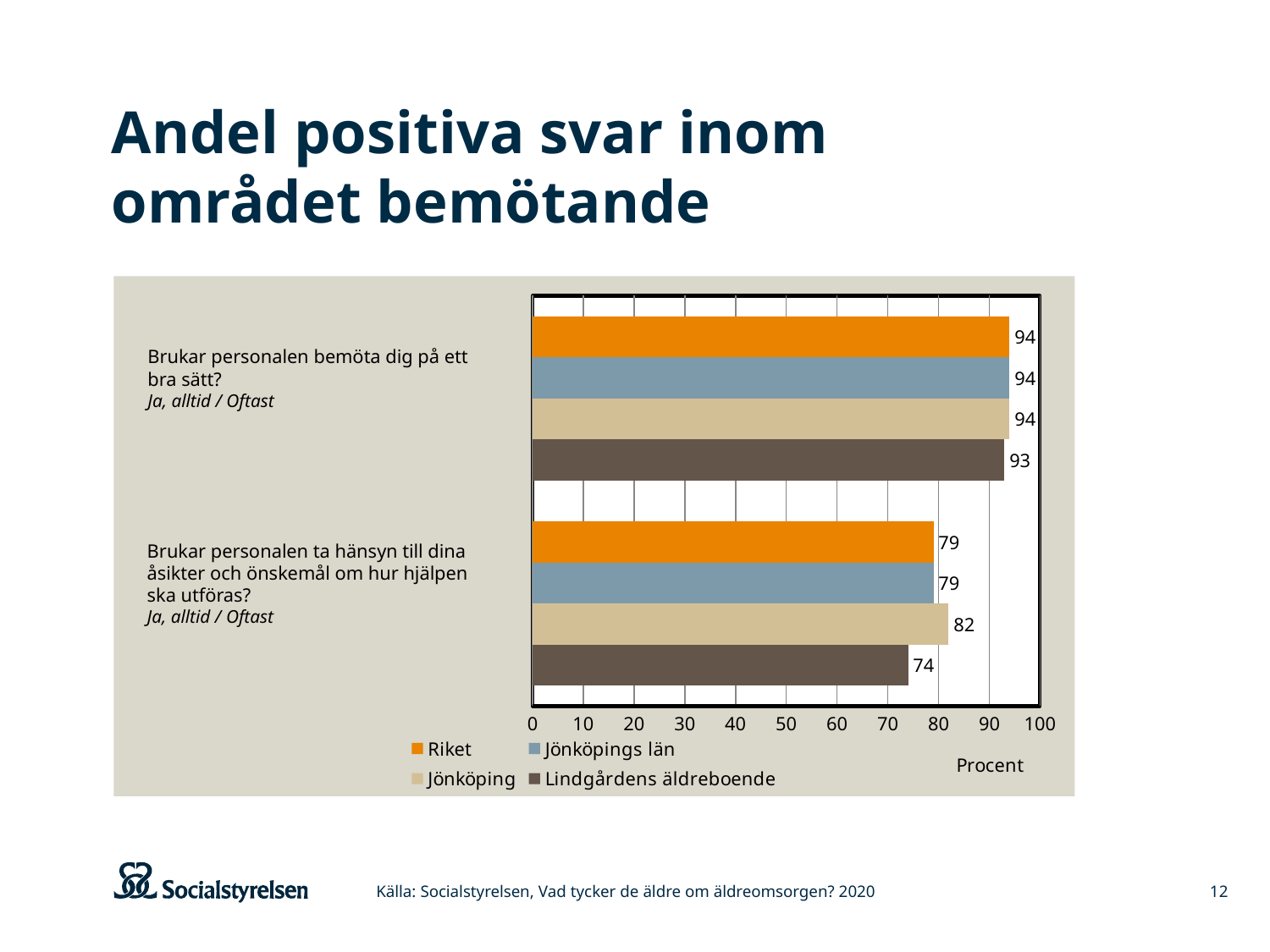
For Lindgårdens äldreboende, which question has the larger value: "Brukar personalen bemöta dig på ett bra sätt?" or "Brukar personalen ta hänsyn till dina åsikter och önskemål om hur hjälpen ska utföras?" Brukar personalen bemöta dig på ett bra sätt? What is the value for Jönköping for the question "Brukar personalen ta hänsyn till dina åsikter och önskemål om hur hjälpen ska utföras?" 82 What is the difference between the Jönköping and Lindgårdens äldreboende values for the question "Brukar personalen ta hänsyn till dina åsikter och önskemål om hur hjälpen ska utföras?" 8 Which series has the lowest value for the question "Brukar personalen ta hänsyn till dina åsikter och önskemål om hur hjälpen ska utföras?" Lindgårdens äldreboende What is the value for Riket for the question "Brukar personalen bemöta dig på ett bra sätt?" 94 Which series is shown in orange in the legend? Riket What is the label of the x axis? Procent Which series has the highest value for the question "Brukar personalen ta hänsyn till dina åsikter och önskemål om hur hjälpen ska utföras?" Jönköping What is the value for Lindgårdens äldreboende for the question "Brukar personalen bemöta dig på ett bra sätt?" 93 What kind of chart is shown on the slide? Bar chart What is the value for Lindgårdens äldreboende for the question "Brukar personalen ta hänsyn till dina åsikter och önskemål om hur hjälpen ska utföras?" 74 How many series does the legend list? 4